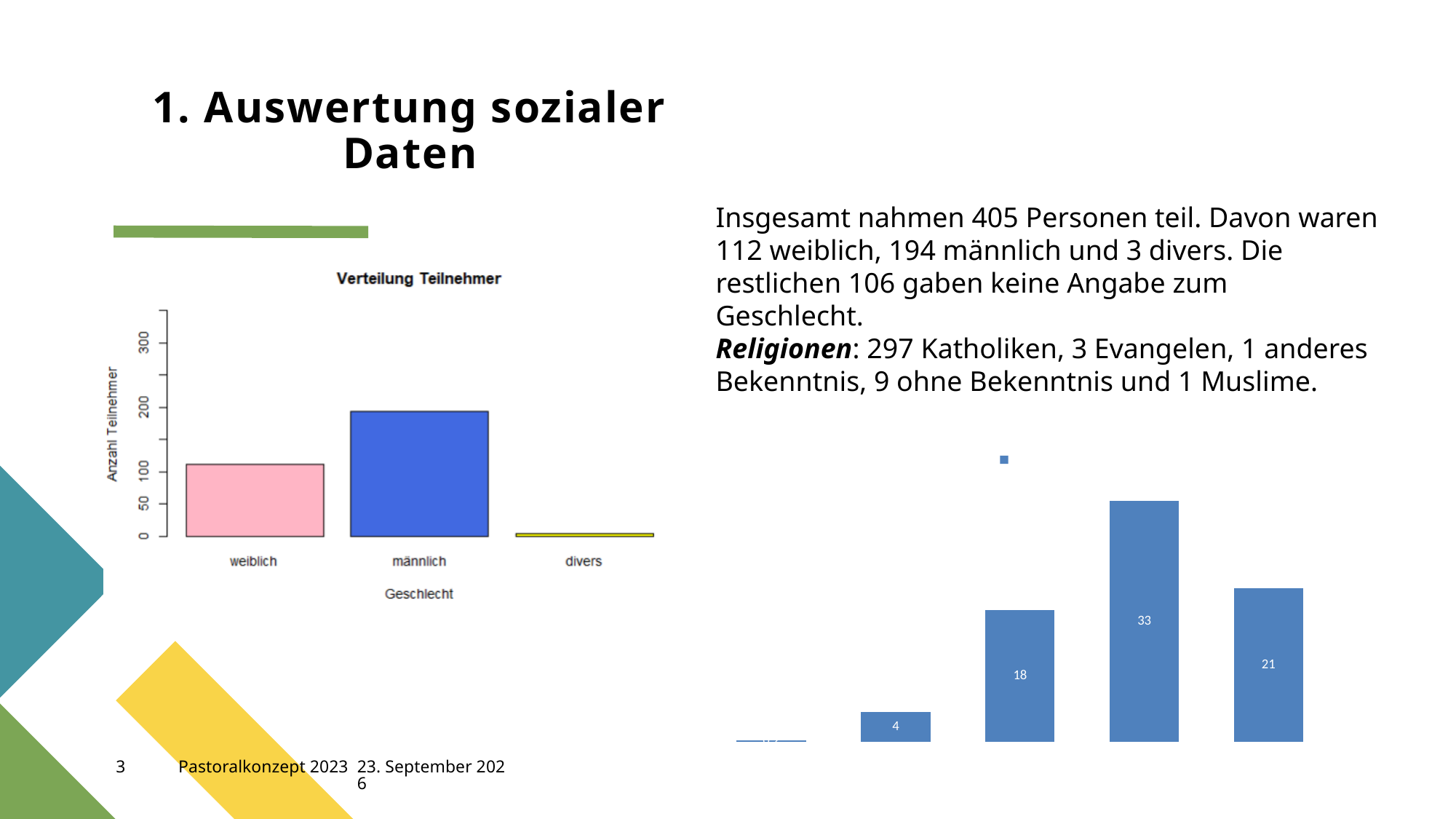
In the 'Verteilung Teilnehmer' chart, which is larger, the bar for weiblich or the bar for männlich? männlich In the bar chart at the bottom right of the slide, what is the highest data label shown? 33 In the 'Verteilung Teilnehmer' chart, is the value for weiblich greater or less than 100? greater In the 'Verteilung Teilnehmer' chart, which category has the highest bar? männlich In the 'Verteilung Teilnehmer' chart, is the value for divers greater or less than 50? less In the bar chart at the bottom right of the slide, what is the difference between the bar labelled 33 and the bar labelled 18? 15 What is the label of the y axis in the 'Verteilung Teilnehmer' chart? Anzahl Teilnehmer What is the label of the x axis in the 'Verteilung Teilnehmer' chart? Geschlecht In the 'Verteilung Teilnehmer' chart, is the value for männlich greater or less than 200? less In the 'Verteilung Teilnehmer' chart, how many categories are shown on the x axis? 3 In the 'Verteilung Teilnehmer' chart, which category has the lowest bar? divers What type of chart is the 'Verteilung Teilnehmer' chart on the left? bar chart